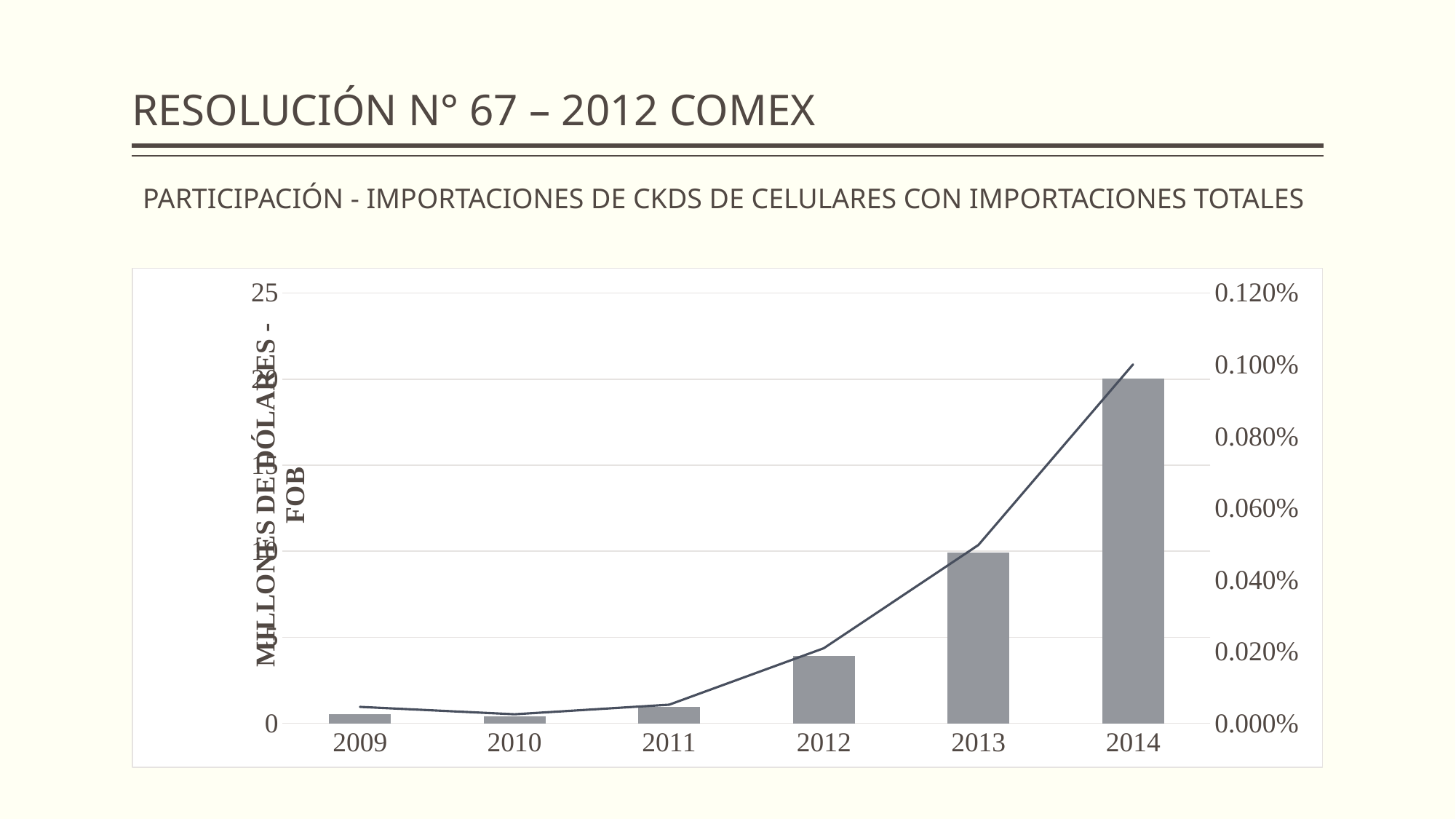
Is the bar value for 2014 greater or less than 15 on the left axis? greater Is the line value for 2012 greater or less than 0.040% on the right axis? less Do the bar values rise or fall from 2011 to 2014? rise Is the bar value for 2012 greater or less than 5 on the left axis? less What is the first year shown on the x axis of the chart? 2009 Which year has the tallest bar in the chart? 2014 Which year has the shortest bar in the chart? 2010 What kind of chart is shown on the slide? A bar chart combined with a line How many years are shown along the x axis of the chart? 6 Which year has a taller bar, 2012 or 2013? 2013